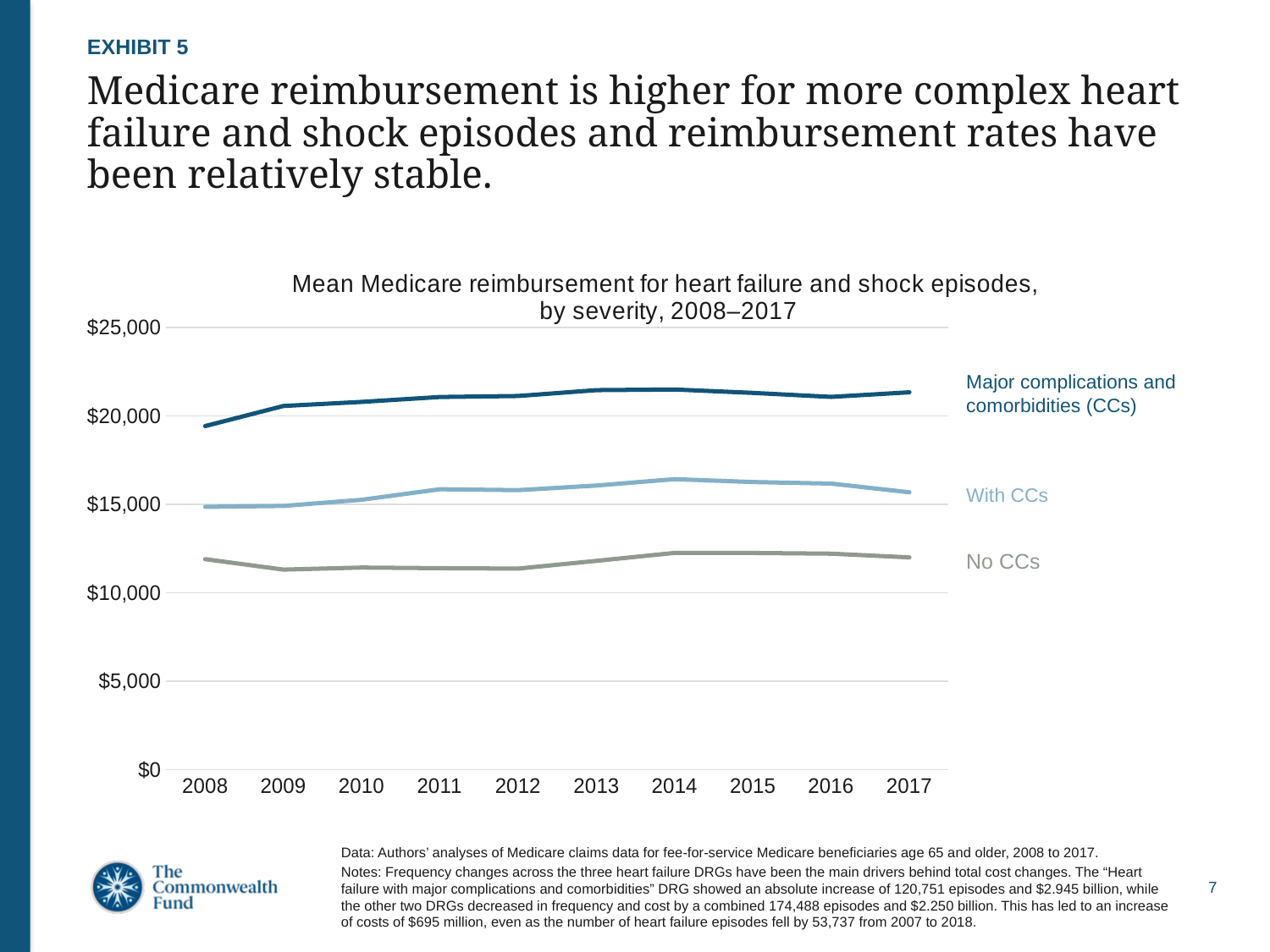
In 2017, which is larger: the value for With CCs or the value for No CCs? With CCs How many years are plotted along the x axis? 10 Does the Major complications and comorbidities (CCs) line rise or fall from 2008 to 2017 overall? rise What is the title of the chart? Mean Medicare reimbursement for heart failure and shock episodes, by severity, 2008–2017 Is the value for No CCs in 2009 greater or less than $10,000? greater Is the value for With CCs in 2014 greater or less than $15,000? greater How many series does the chart show? 3 Which severity group has the lowest mean Medicare reimbursement across the period? No CCs Which severity group has the highest mean Medicare reimbursement across the period? Major complications and comorbidities (CCs) Is the value for Major complications and comorbidities (CCs) in 2008 greater or less than $20,000? less What kind of chart is shown on the slide? line chart